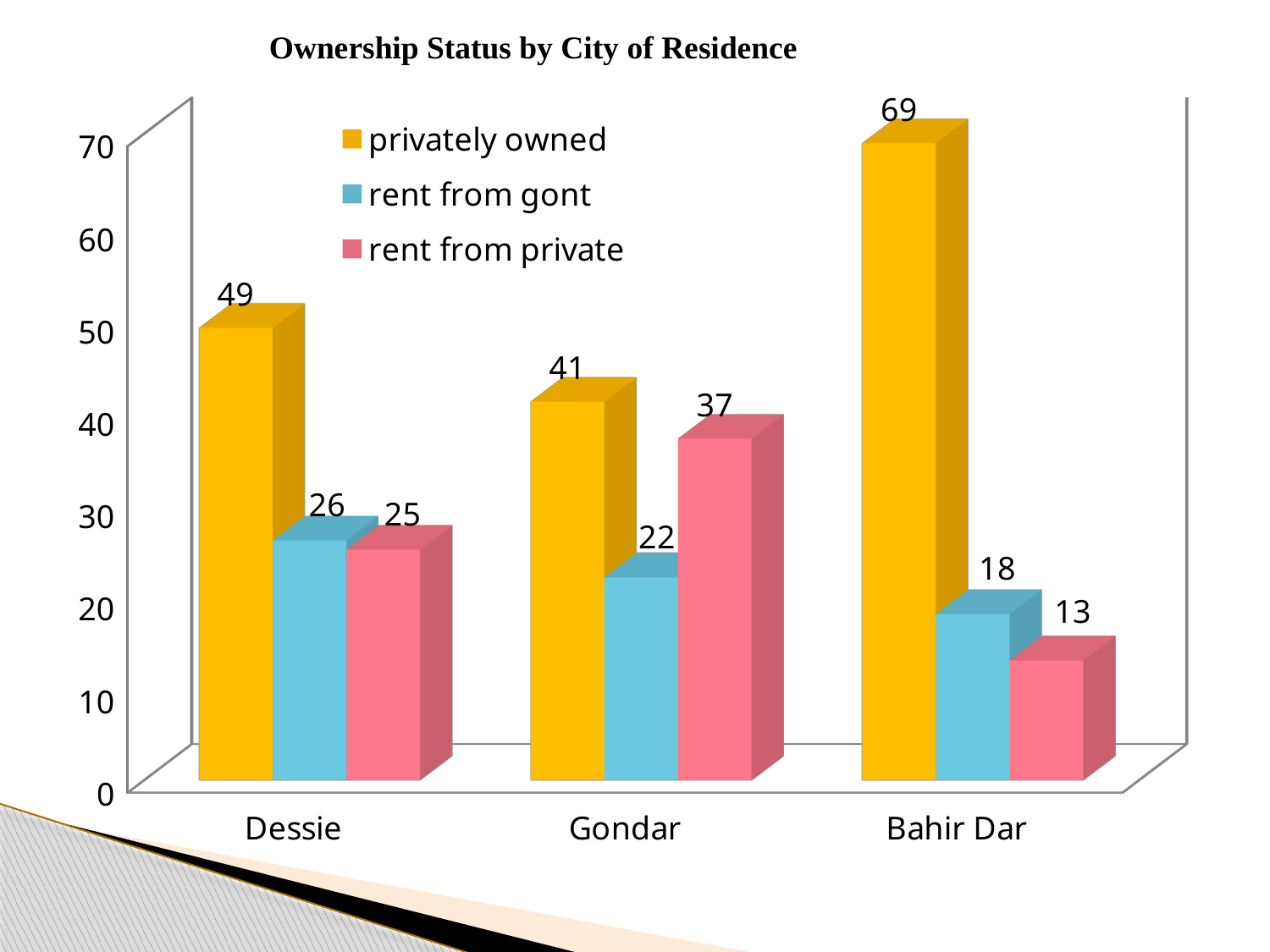
Which city has the highest value for privately owned? Bahir Dar What is the value for privately owned in Bahir Dar? 69 What is the difference between privately owned and rent from gont in Bahir Dar? 51 What is the title of the chart? Ownership Status by City of Residence How many series does the legend list? 3 What is the value for rent from private in Gondar? 37 What is the value for rent from gont in Dessie? 26 How many cities are shown on the x axis? 3 Which city has the lowest value for rent from private? Bahir Dar What kind of chart is shown on the slide? bar chart Is the value for privately owned in Dessie greater or less than 40? greater Which is larger in Gondar: privately owned or rent from private? privately owned